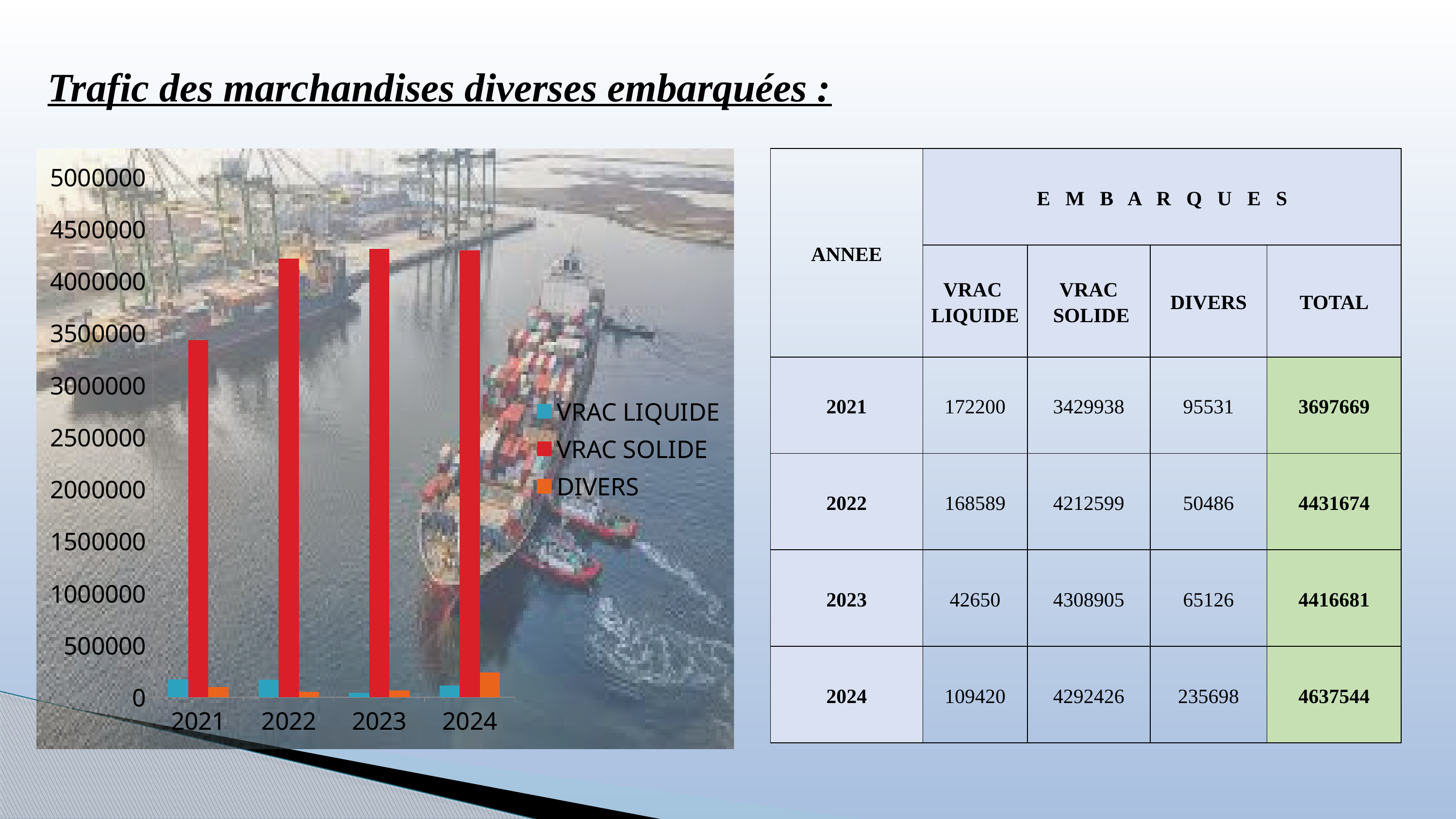
Is the VRAC SOLIDE value for 2023 greater or less than 4000000? greater Which colour represents VRAC SOLIDE in the chart legend? red What kind of chart is shown on the slide? bar chart Which year has the tallest DIVERS bar? 2024 Is the VRAC SOLIDE value for 2022 greater or less than 4500000? less According to the table, what is the VRAC SOLIDE value for 2024? 4292426 How many series does the chart legend list? 3 Which series has the tallest bars in every year of the chart? VRAC SOLIDE How many years are shown on the x axis of the chart? 4 Is the VRAC SOLIDE value for 2021 greater or less than 4000000? less Which year has the lowest VRAC SOLIDE bar? 2021 Is the VRAC LIQUIDE bar for 2022 taller or shorter than the VRAC LIQUIDE bar for 2023? taller